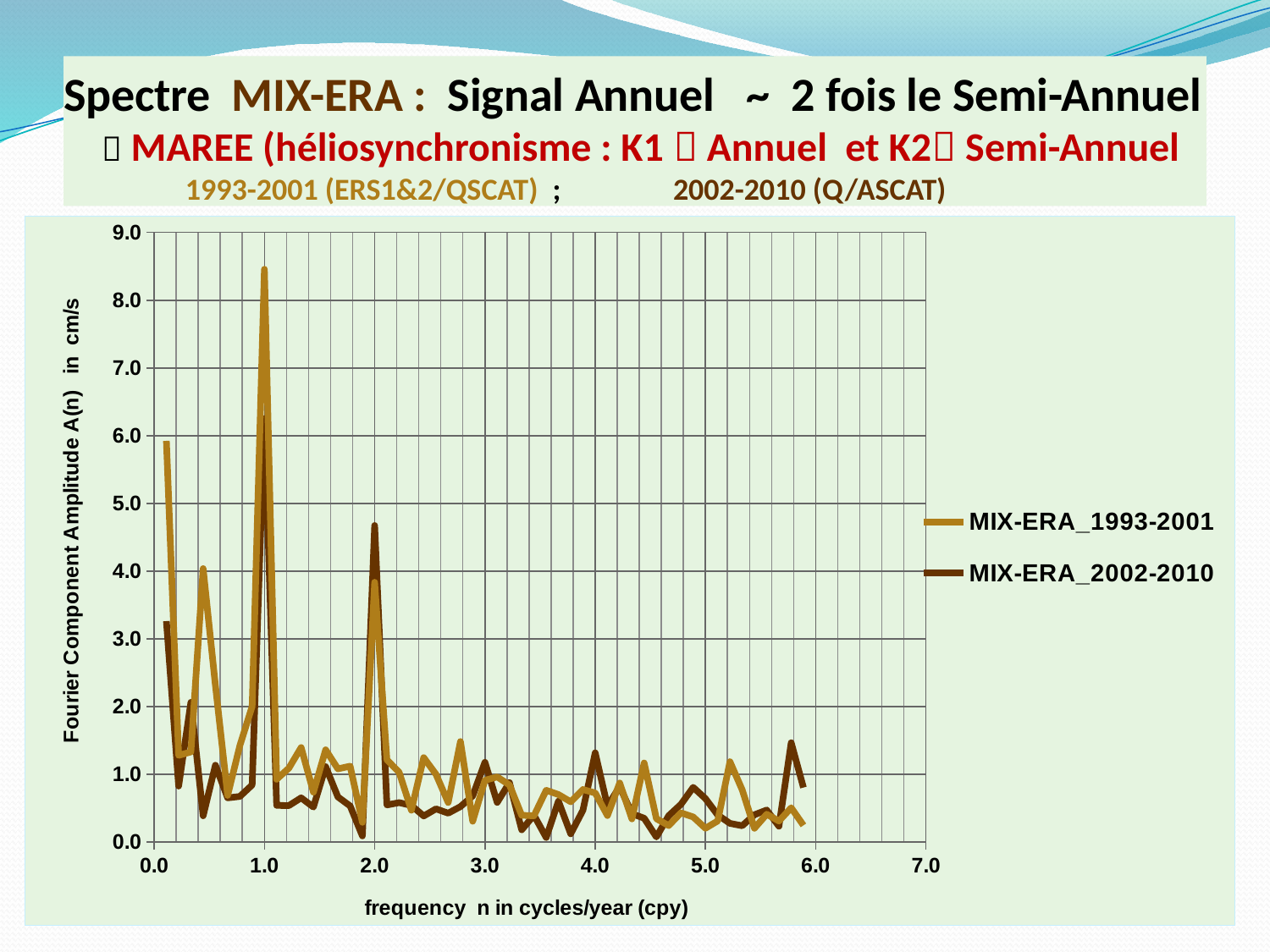
At 1.0 cpy, which series has the larger amplitude, MIX-ERA_1993-2001 or MIX-ERA_2002-2010? MIX-ERA_1993-2001 At 2.0 cpy, which series has the larger amplitude, MIX-ERA_1993-2001 or MIX-ERA_2002-2010? MIX-ERA_2002-2010 What is the label of the x axis? frequency n in cycles/year (cpy) At which frequency does the MIX-ERA_2002-2010 series reach its highest amplitude? 1.0 cpy How many series does the legend list? 2 Is the peak value of MIX-ERA_1993-2001 at 1.0 cpy greater or less than 8.0? greater Is the peak value of MIX-ERA_2002-2010 at 1.0 cpy greater or less than 6.0? greater What are the two series named in the legend? MIX-ERA_1993-2001 and MIX-ERA_2002-2010 Is the value of MIX-ERA_1993-2001 at 2.0 cpy greater or less than 5.0? less What kind of chart is shown on the slide? line chart At which frequency does the MIX-ERA_1993-2001 series reach its highest amplitude? 1.0 cpy